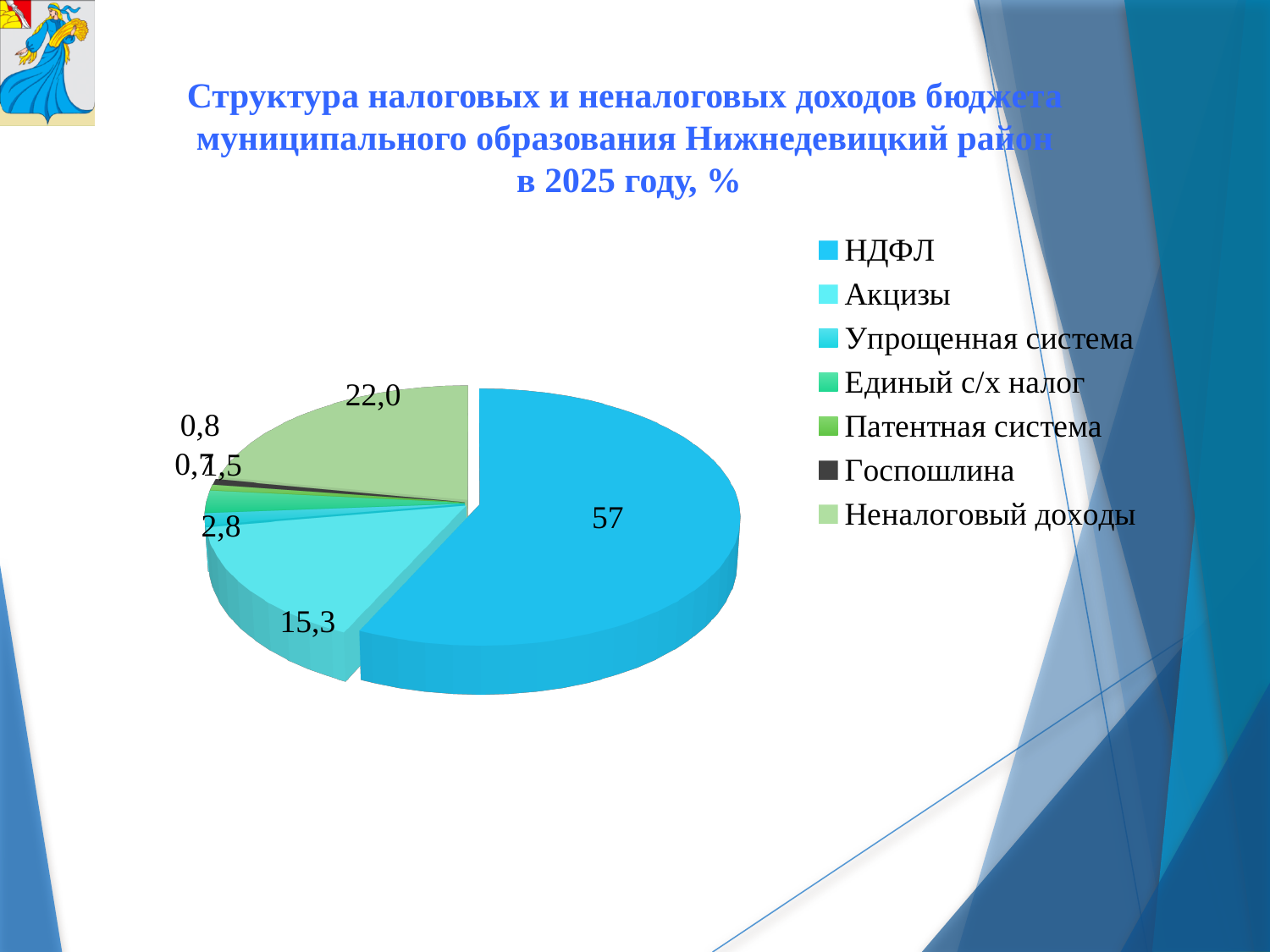
Which legend entry is shown in dark grey? Госпошлина What year does the chart title refer to? 2025 What is the value shown for Акцизы? 15,3 Which category has the largest slice of the pie? НДФЛ Which is larger, the slice for Упрощенная система or the slice for Акцизы? Акцизы Which is larger, the slice for Акцизы or the slice for Неналоговый доходы? Неналоговый доходы What is the difference between the values for НДФЛ and Неналоговый доходы? 35 What is the value shown for Неналоговый доходы? 22,0 How many categories does the legend list? 7 What is the value shown for НДФЛ? 57 What type of chart is shown on the slide? Pie chart